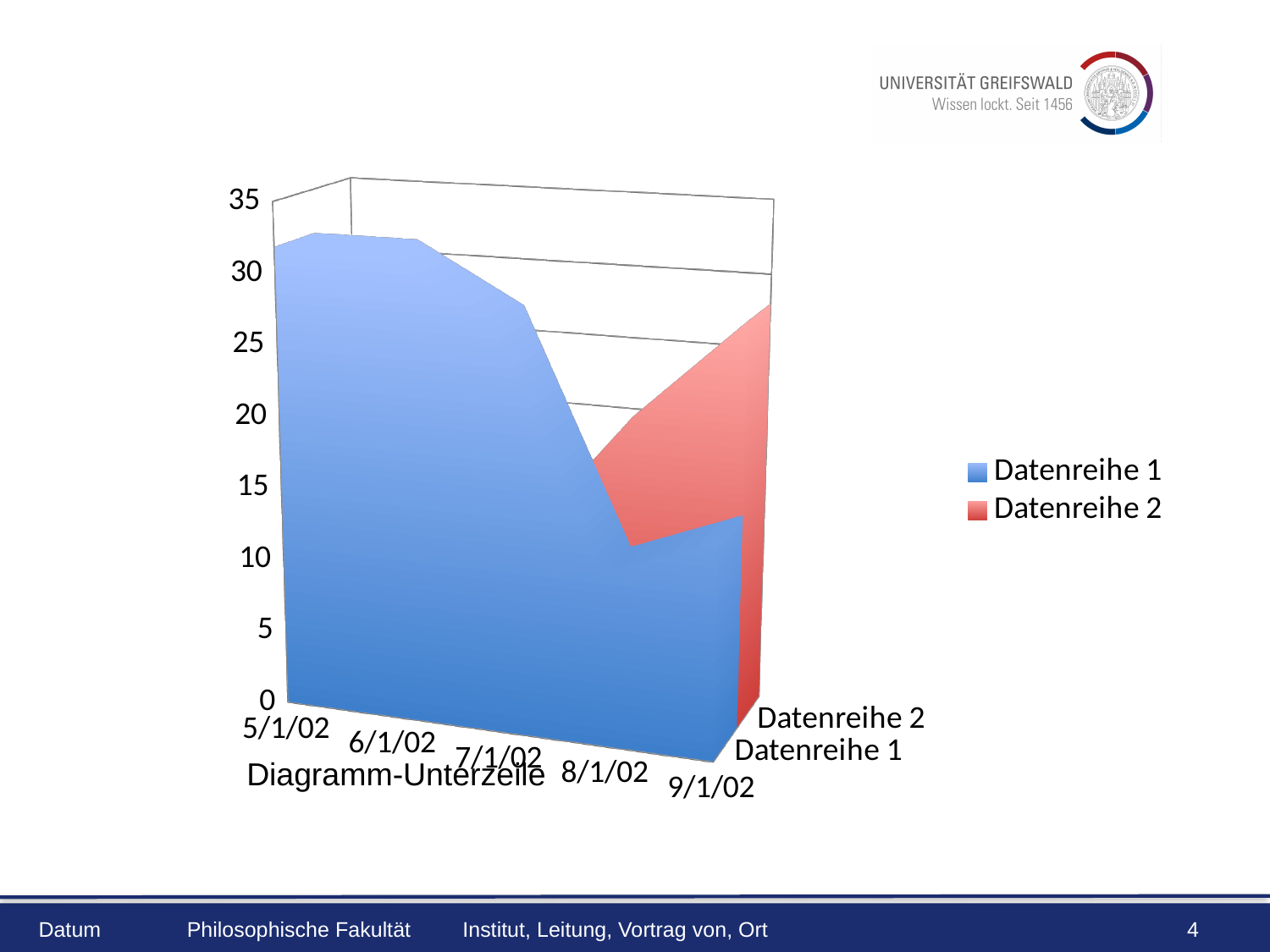
At which date does Datenreihe 1 reach its lowest value? 8/1/02 What text appears as the axis title below the x axis? Diagramm-Unterzeile What kind of chart is shown on the slide? Area chart Is the value of Datenreihe 1 at 8/1/02 greater or less than 15? less Does Datenreihe 1 rise or fall from 5/1/02 to 8/1/02? Fall Is the value of Datenreihe 1 at 7/1/02 greater or less than 25? greater How many series does the legend list? 2 Which series is shown in blue? Datenreihe 1 At 9/1/02, which series has the larger value, Datenreihe 1 or Datenreihe 2? Datenreihe 2 How many dates are shown along the x axis? 5 Is the value of Datenreihe 2 at 9/1/02 greater or less than 20? greater Does Datenreihe 2 rise or fall from 8/1/02 to 9/1/02? Rise